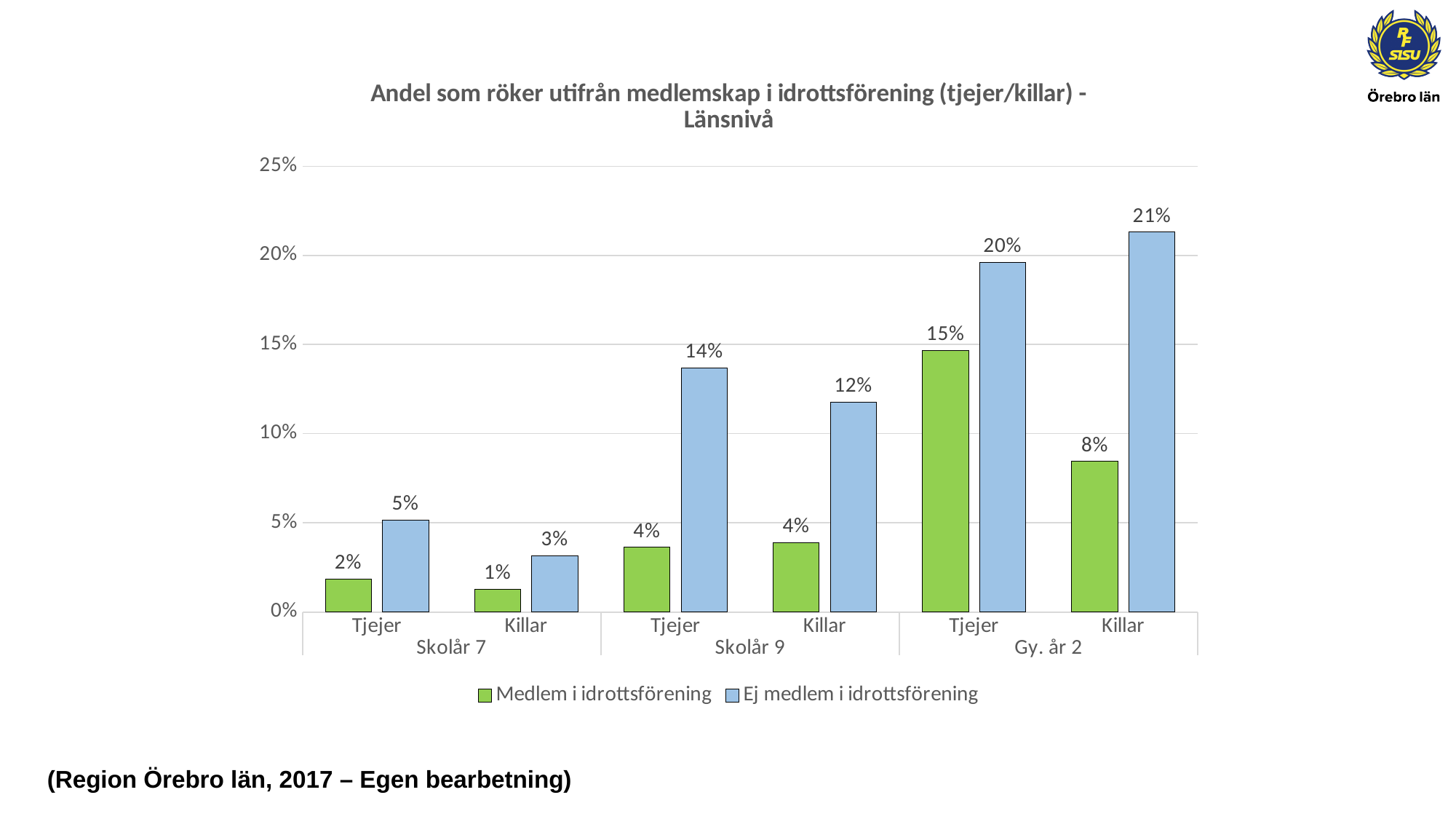
What is the value for "Ej medlem i idrottsförening" for Killar in Gy. år 2? 21% What is the value for "Medlem i idrottsförening" for Tjejer in Skolår 9? 4% What kind of chart is shown on the slide? Bar chart How many groups (bar pairs) are shown on the x axis? 6 How many series does the legend list? 2 What is the value for "Ej medlem i idrottsförening" for Tjejer in Gy. år 2? 20% Which group has the highest value for "Medlem i idrottsförening"? Tjejer, Gy. år 2 Which colour represents "Medlem i idrottsförening" in the chart? Green What is the value for "Medlem i idrottsförening" for Killar in Skolår 7? 1% What is the difference between "Ej medlem i idrottsförening" and "Medlem i idrottsförening" for Killar in Gy. år 2? 13% Which group has the lowest value for "Ej medlem i idrottsförening"? Killar, Skolår 7 Which is larger for Tjejer in Skolår 9: "Medlem i idrottsförening" or "Ej medlem i idrottsförening"? Ej medlem i idrottsförening